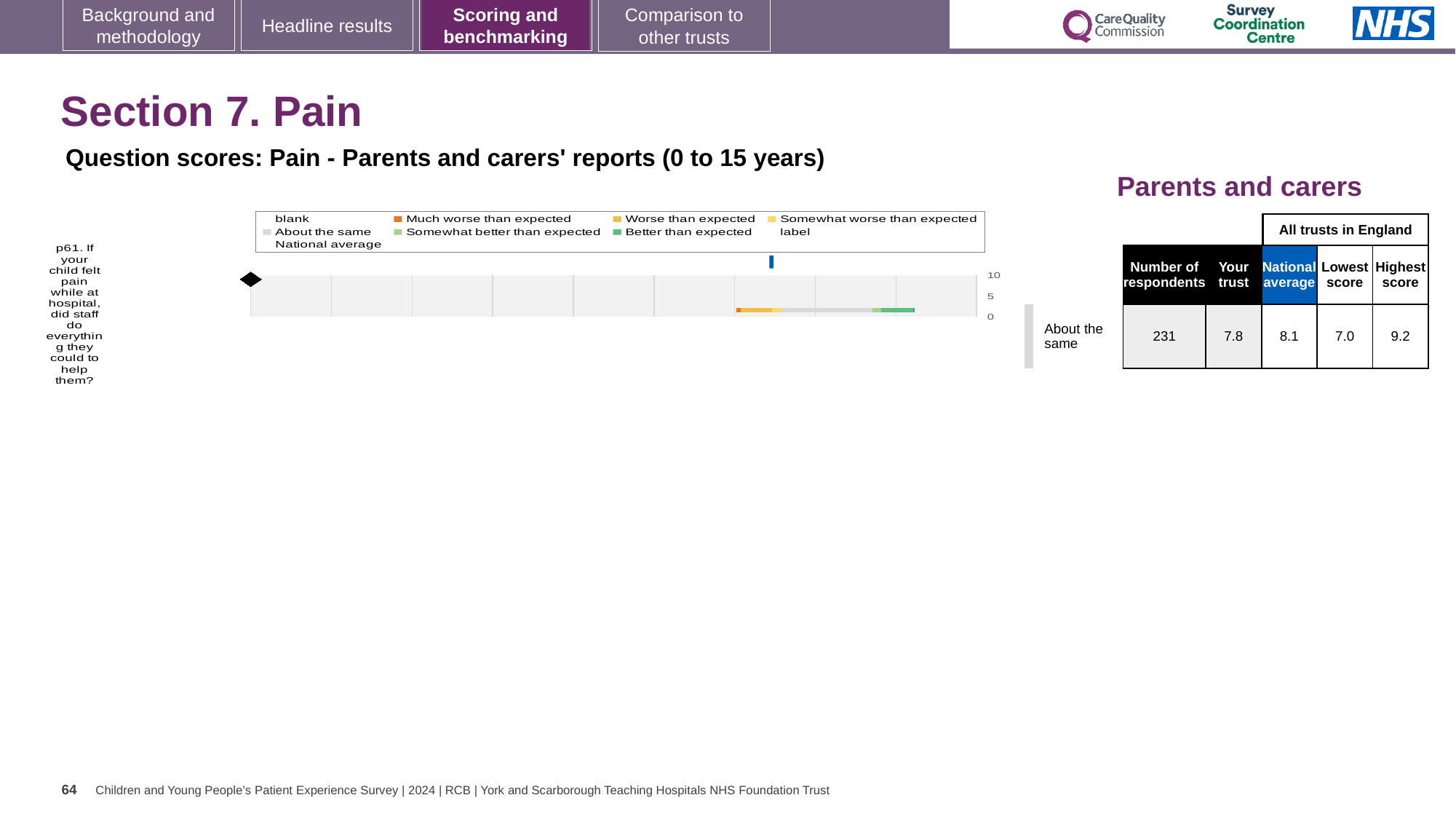
What is the national average score for the p61 pain question shown on the slide? 8.1 What is the highest score among all trusts in England for the p61 pain question? 9.2 What kind of chart is shown on the slide? bar chart Which benchmark category is the trust's score for p61 placed in, according to the label beside the chart? About the same How many survey questions are plotted in the chart? 1 What is the difference between the highest score (9.2) and the lowest score (7.0) for the p61 pain question? 2.2 What is the 'Your trust' score for the p61 pain question shown on the slide? 7.8 What is the highest tick value shown on the chart's score axis? 10 What is the lowest score among all trusts in England for the p61 pain question? 7.0 How many respondents answered the p61 pain question? 231 Which question is plotted in the chart? p61. If your child felt pain while at hospital, did staff do everything they could to help them? Which is larger for the p61 pain question: the 'Your trust' score or the national average? National average